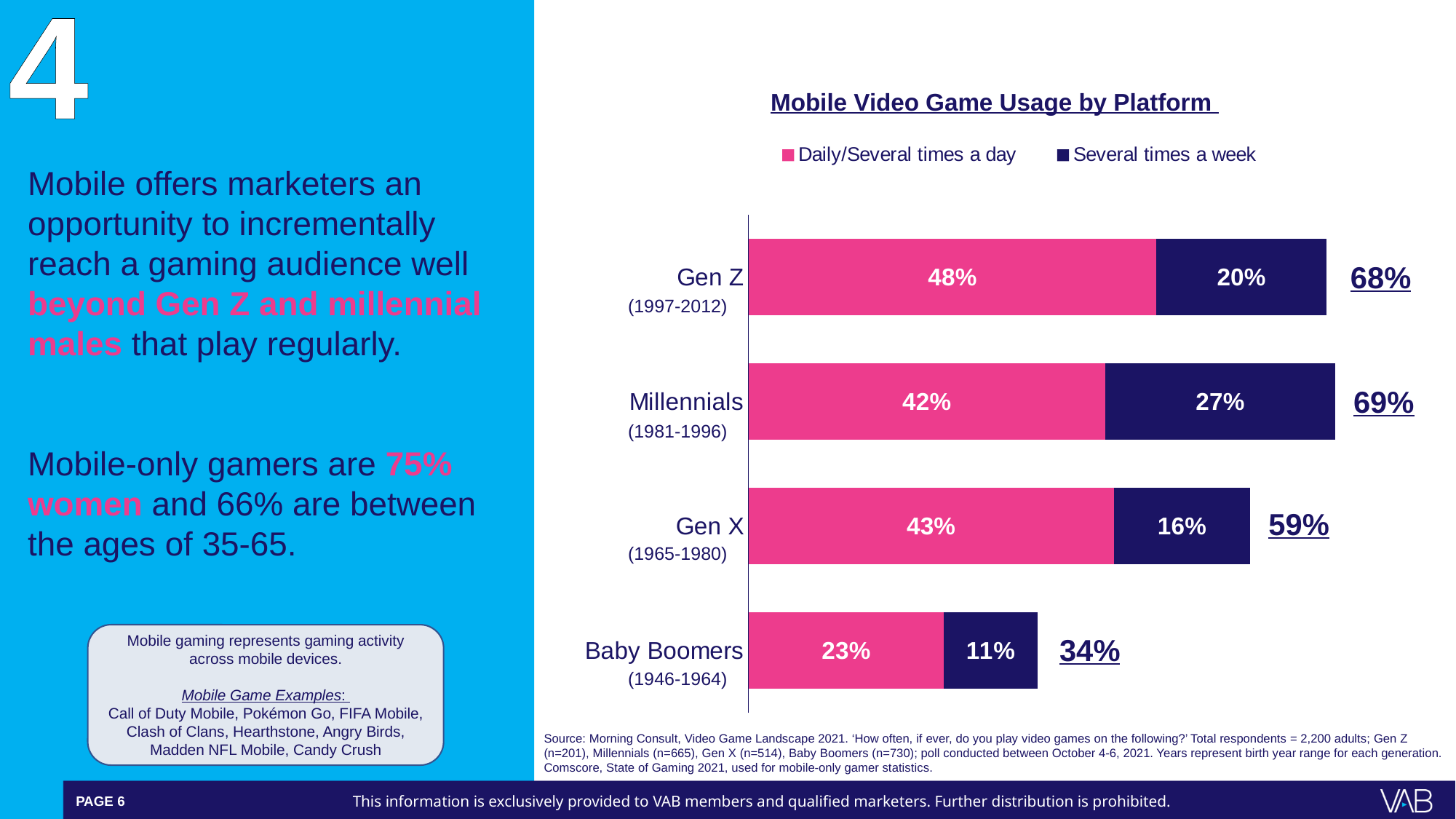
What is the title of the chart? Mobile Video Game Usage by Platform Which generation has the highest 'Daily/Several times a day' value? Gen Z Which generation has the lowest 'Several times a week' value? Baby Boomers What is the 'Daily/Several times a day' value for Baby Boomers? 23% What is the difference between the 'Daily/Several times a day' values for Gen Z and Baby Boomers? 25% What is the total of the stacked bar for Gen X? 59% What is the 'Several times a week' value for Millennials? 27% How many generations are shown in the chart? 4 Which is larger: the 'Several times a week' value for Gen Z or for Gen X? Gen Z What is the 'Daily/Several times a day' value for Gen Z? 48% What kind of chart is shown? Stacked bar chart How many series does the legend list? 2